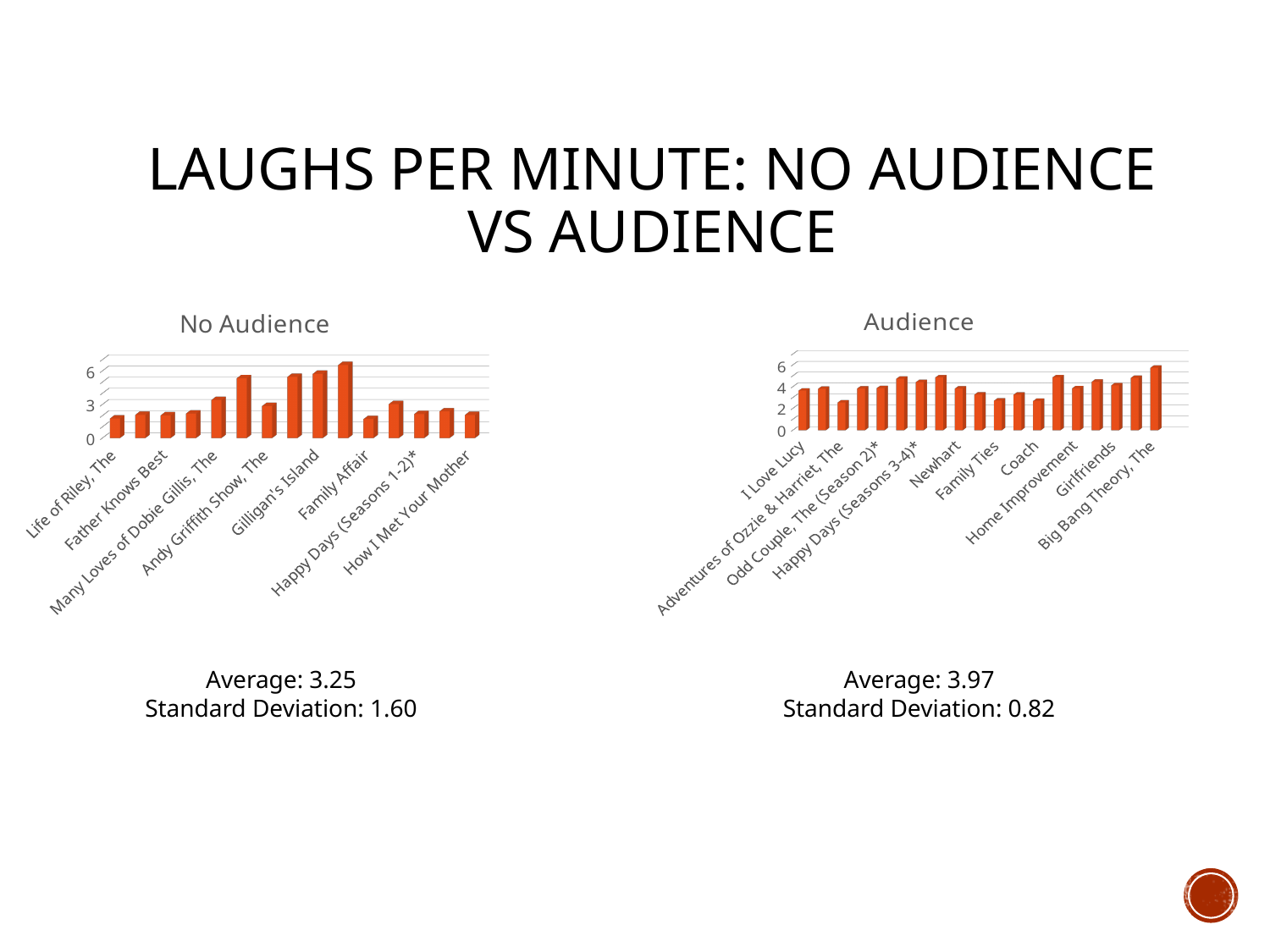
In the No Audience chart, is the value for Life of Riley, The greater or less than 3? less What average is printed below the No Audience chart? 3.25 What kind of chart is the No Audience chart? bar chart In the No Audience chart, is the value for How I Met Your Mother greater or less than 3? less In the No Audience chart, is the value for Family Affair greater or less than 3? less What is the title of the chart on the right side of the slide? Audience In the Audience chart, which show has the highest laughs per minute? Big Bang Theory, The In the No Audience chart, which is larger, the value for Gilligan's Island or the value for Father Knows Best? Gilligan's Island In the Audience chart, which is larger, the value for Big Bang Theory, The or the value for Coach? Big Bang Theory, The